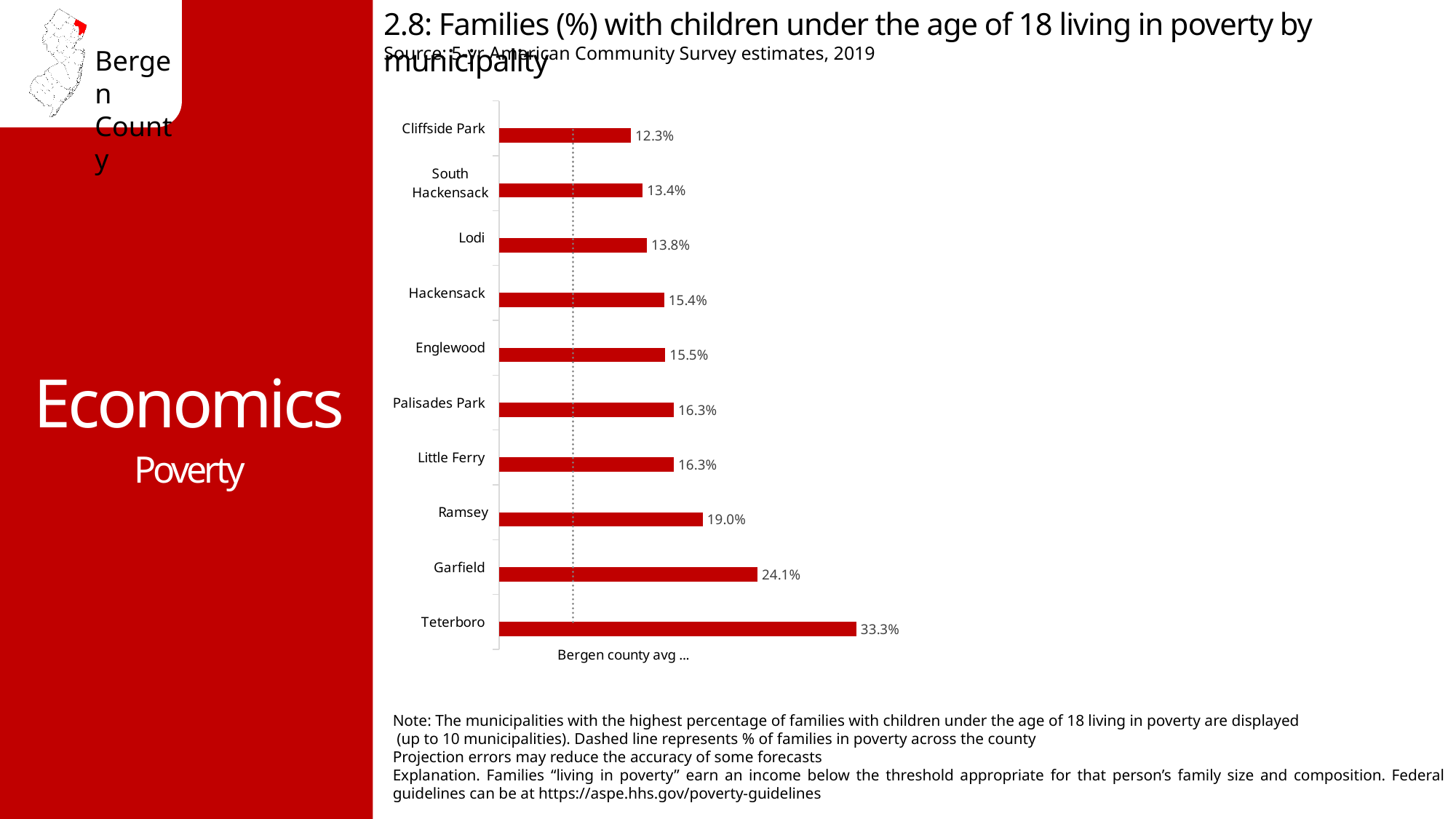
What is the difference between the values for Ramsey and Lodi? 5.2% What is the value for Garfield? 24.1% Which municipality has the highest value? Teterboro What is the difference between the values for Teterboro and Garfield? 9.2% What is the value for Cliffside Park? 12.3% Which municipality has the lowest value? Cliffside Park What does the dashed vertical line in the chart represent? Bergen county average (% of families in poverty across the county) How many municipalities are shown in the chart? 10 What kind of chart is shown on the slide? Bar chart What is the value for Teterboro? 33.3% What is the value for Hackensack? 15.4% Which is larger, the value for Ramsey or the value for Englewood? Ramsey